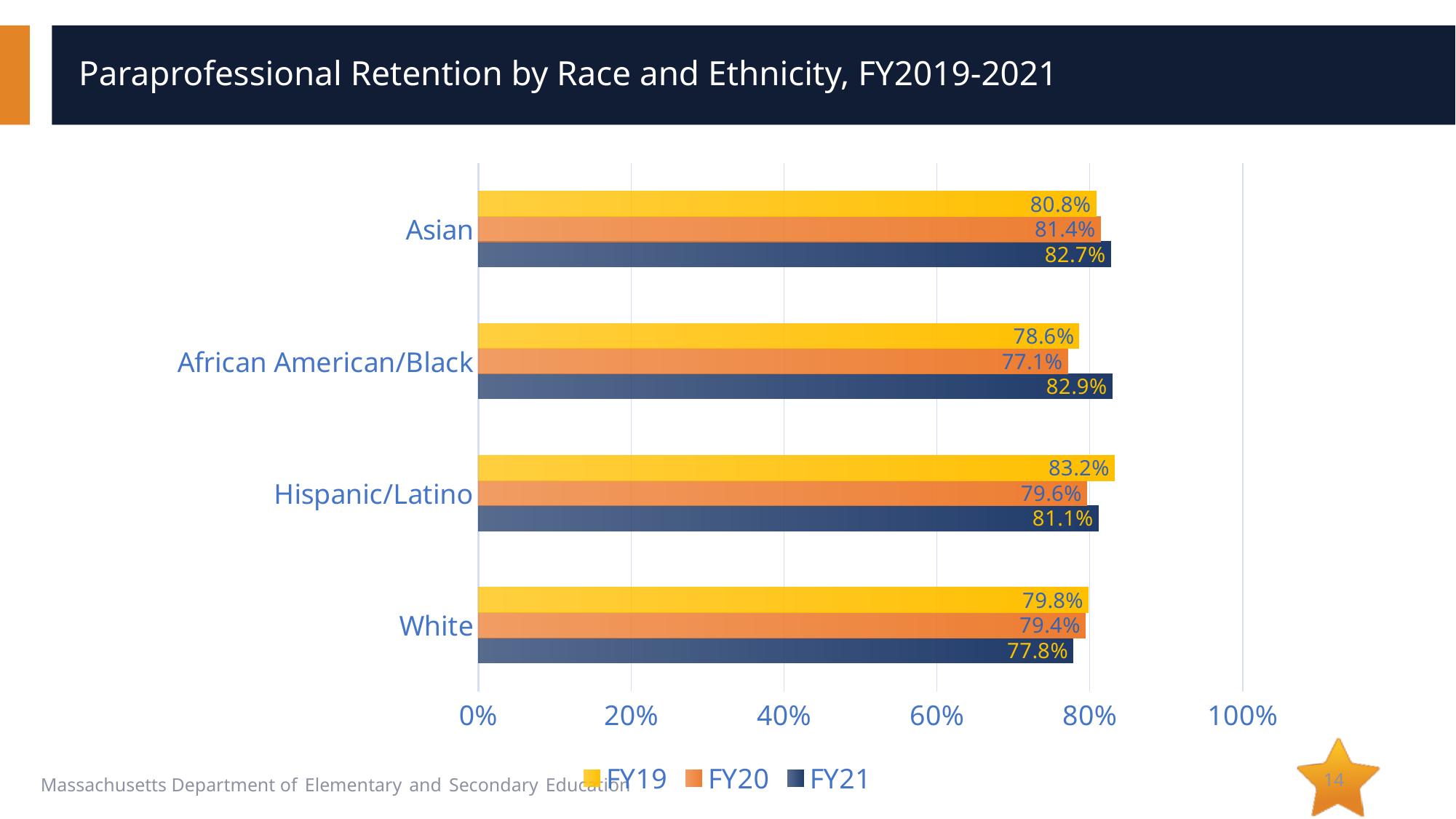
What kind of chart is shown on the slide? Bar chart Which is larger for Hispanic/Latino paraprofessionals: the FY19 rate or the FY21 rate? FY19 Which race/ethnicity group has the highest FY21 retention rate? African American/Black What is the FY21 retention rate for White paraprofessionals? 77.8% How many race/ethnicity categories are shown on the chart? 4 Did the retention rate for White paraprofessionals rise or fall from FY19 to FY21? Fall What is the FY19 retention rate for Hispanic/Latino paraprofessionals? 83.2% What is the difference between the FY21 and FY20 retention rates for African American/Black paraprofessionals? 5.8% What is the FY21 retention rate for Asian paraprofessionals? 82.7% How many series does the legend list? 3 Which race/ethnicity group has the lowest FY20 retention rate? African American/Black What is the FY20 retention rate for African American/Black paraprofessionals? 77.1%